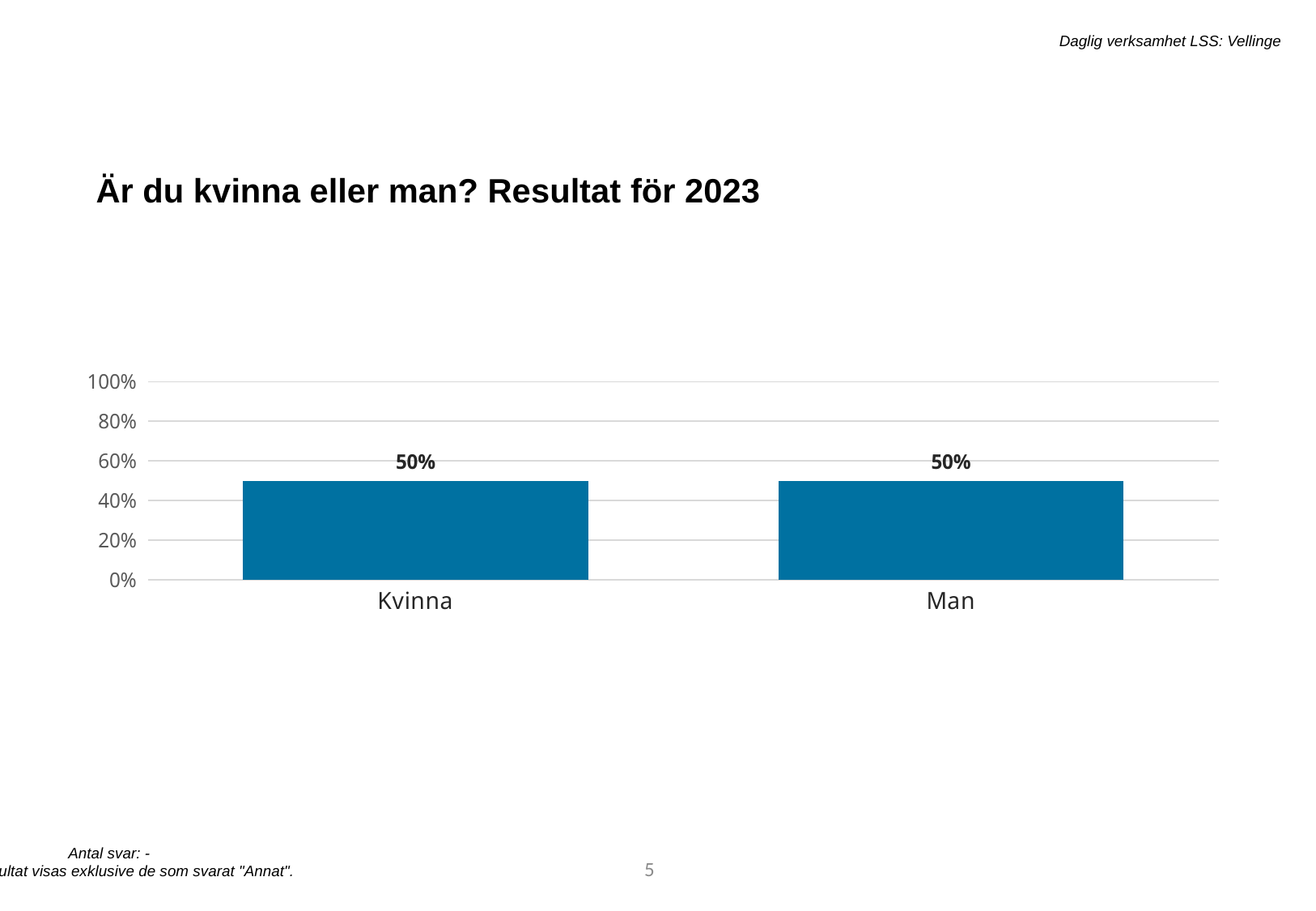
What is the total of the values for Kvinna and Man? 100% What is the title of the chart? Är du kvinna eller man? Resultat för 2023 What is the value for Man? 50% What kind of chart is shown on the slide? bar chart Is the value for Man greater or less than 20%? greater Is the value for Kvinna greater or less than 80%? less How many categories are shown on the x axis? 2 Are the values for Kvinna and Man equal? yes What is the value for Kvinna? 50% What is the highest value shown on the y axis? 100% What is the difference between the values for Kvinna and Man? 0%